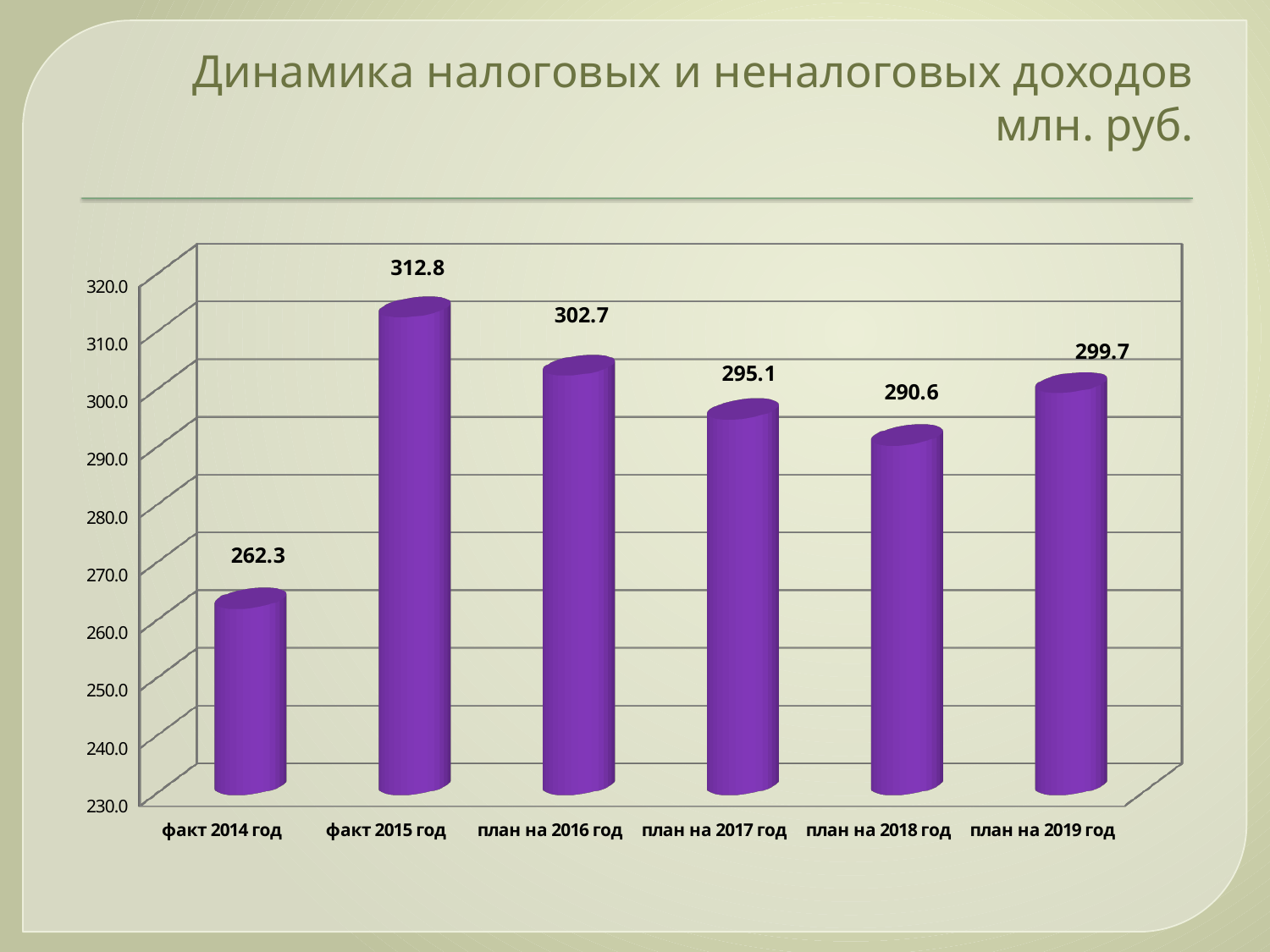
What is the title of the chart on the slide? Динамика налоговых и неналоговых доходов млн. руб. What is the difference between the values for факт 2015 год and факт 2014 год? 50.5 Is the value for план на 2019 год greater or less than 290.0? greater What is the value for план на 2018 год? 290.6 What kind of chart is shown on the slide? bar chart Which category has the lowest value? факт 2014 год Which category has the highest value? факт 2015 год What is the value for факт 2014 год? 262.3 What is the value for факт 2015 год? 312.8 Which is larger, the value for план на 2016 год or the value for план на 2017 год? план на 2016 год How many categories are shown on the x axis? 6 What is the difference between the values for план на 2019 год and план на 2018 год? 9.1